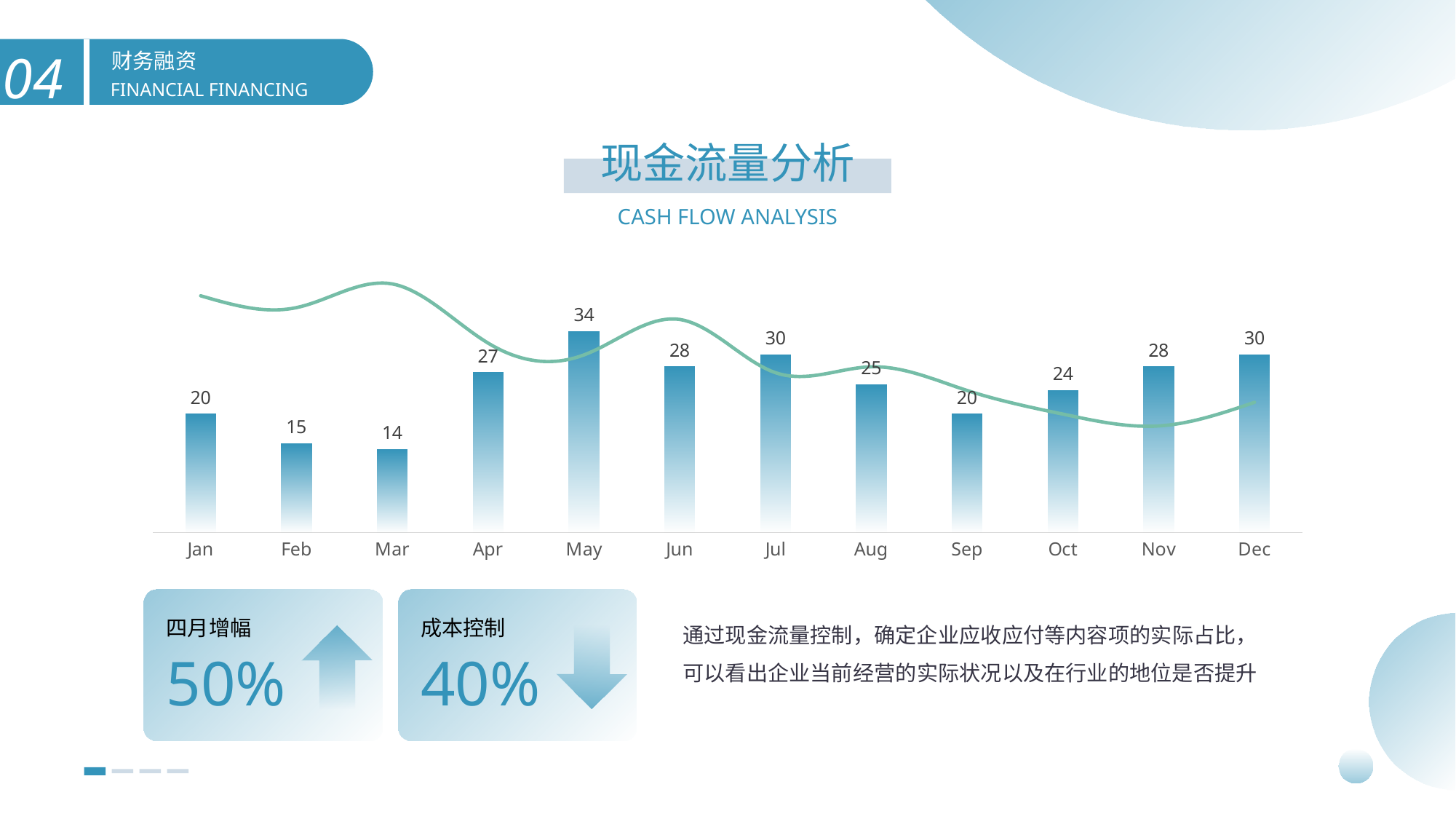
Which month has the highest bar? May How many months are shown on the x axis? 12 What is the difference between the values for May and Mar? 20 What is the value for Oct? 24 What is the English title of the chart? CASH FLOW ANALYSIS What is the value for Mar? 14 Do the bar values rise or fall from Jan to Mar? Fall What is the difference between the values for Dec and Sep? 10 Which month has the lowest bar? Mar Which is larger, the value for Jul or the value for Aug? Jul What kind of chart is used to plot the monthly values? Combination bar and line chart What is the value for May? 34